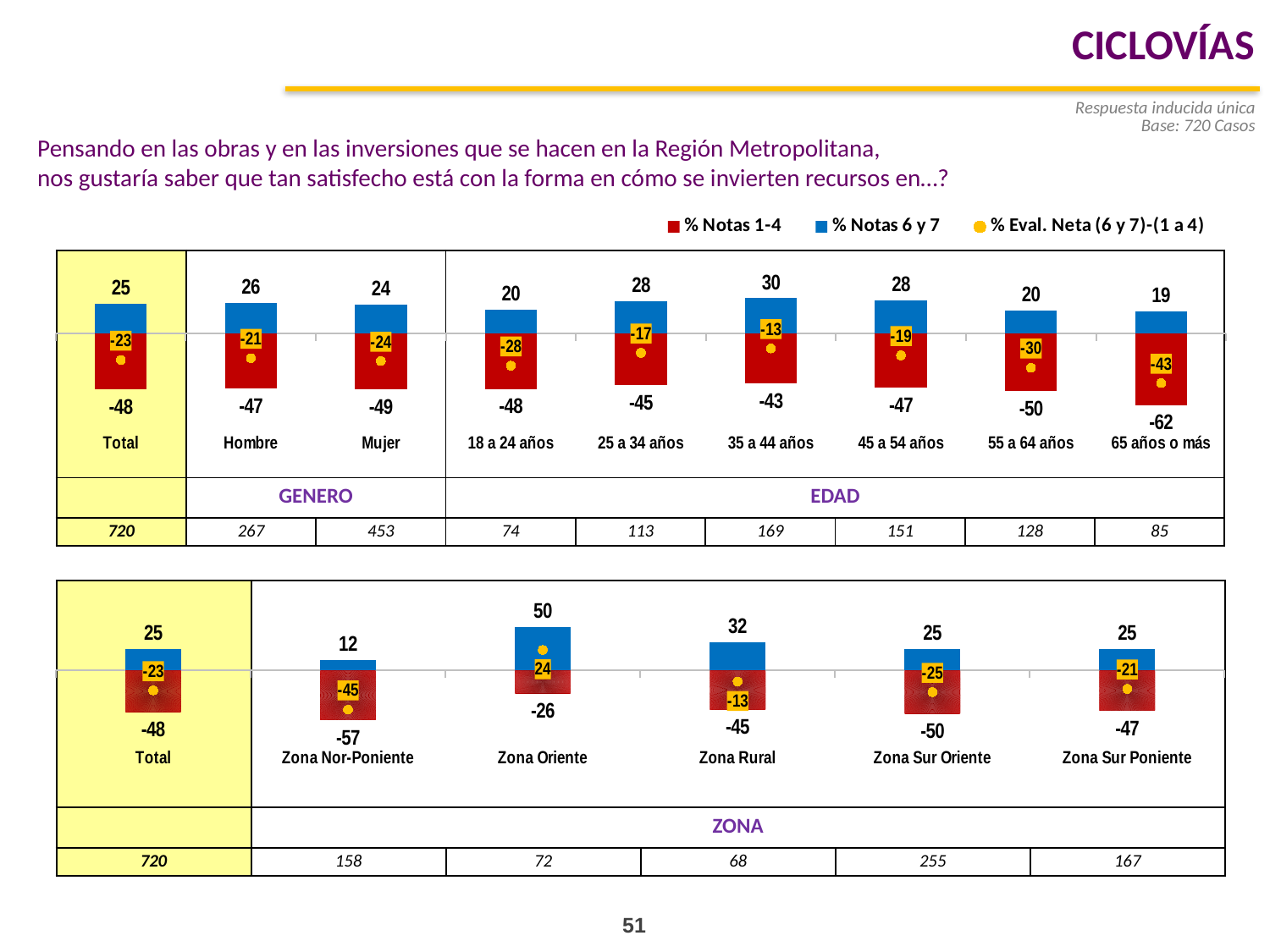
In the top chart (Género/Edad), what is the % Eval. Neta value for Hombre? -21 In the top chart (Género/Edad), what is the % Notas 6 y 7 value for 35 a 44 años? 30 In the top chart (Género/Edad), which age group has the highest % Notas 6 y 7 value? 35 a 44 años How many series does the legend list for the charts? 3 In the bottom chart (Zona), what is the % Eval. Neta value for Zona Nor-Poniente? -45 How many zone categories (excluding Total) are shown in the bottom chart? 5 In the top chart (Género/Edad), which category has the lowest % Eval. Neta value? 65 años o más In the top chart (Género/Edad), what is the difference between the % Notas 6 y 7 values for Hombre and Mujer? 2 In the bottom chart (Zona), which zone has the highest % Eval. Neta value? Zona Oriente In the bottom chart (Zona), which is larger in % Notas 6 y 7: Zona Rural or Zona Sur Oriente? Zona Rural In the top chart (Género/Edad), what is the % Notas 1-4 value for 65 años o más? -62 In the bottom chart (Zona), what is the % Notas 6 y 7 value for Zona Oriente? 50